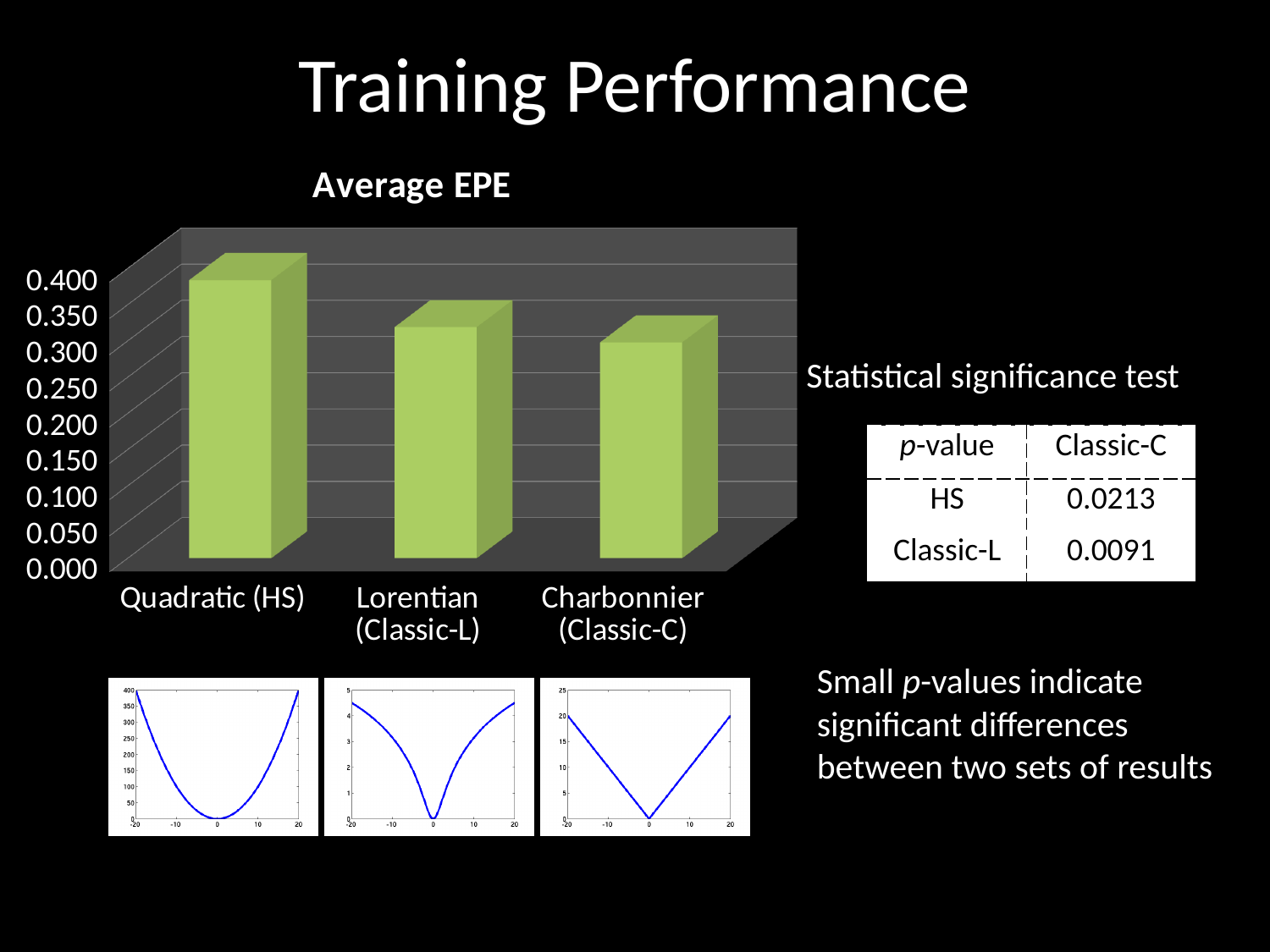
How many categories are shown in the Average EPE chart? 3 Which category has the highest Average EPE? Quadratic (HS) What kind of chart is the Average EPE chart? bar chart Which category has the lowest Average EPE? Charbonnier (Classic-C) In the Average EPE chart, is the value for Charbonnier (Classic-C) greater or less than 0.350? less Do the Average EPE values rise or fall from left to right across the categories? fall In the Average EPE chart, is the value for Charbonnier (Classic-C) greater or less than 0.250? greater In the Average EPE chart, is the value for Lorentian (Classic-L) greater or less than 0.400? less What is the title of the bar chart? Average EPE In the Average EPE chart, which is larger: Quadratic (HS) or Charbonnier (Classic-C)? Quadratic (HS) What is the highest tick value shown on the vertical axis of the Average EPE chart? 0.400